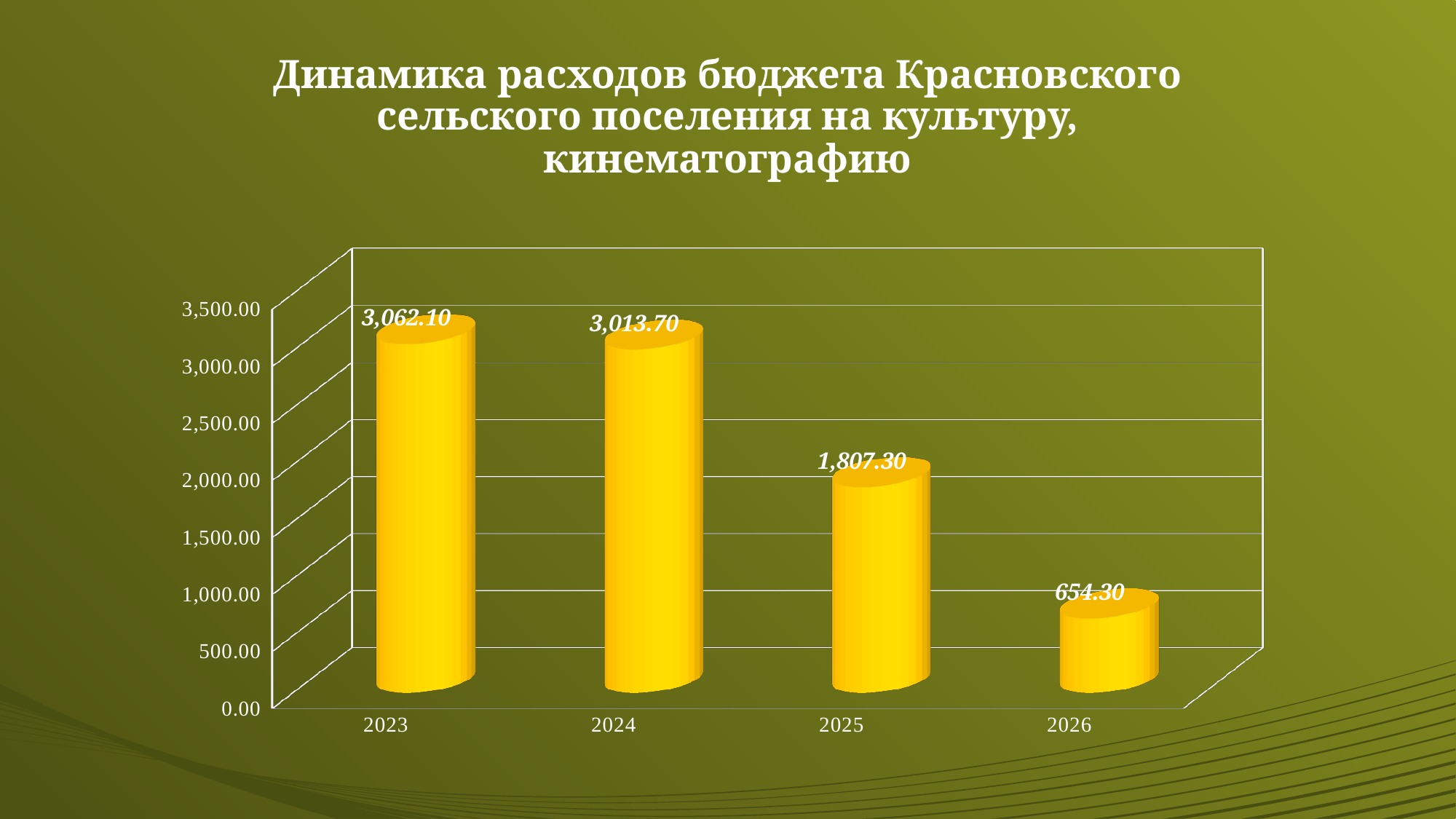
Which year has the lowest value? 2026 What is the value for 2023? 3,062.10 Which year has the highest value? 2023 What is the value for 2025? 1,807.30 What is the difference between the values for 2023 and 2024? 48.40 Do the values rise or fall from 2023 to 2026? fall What kind of chart is this? bar chart What is the value for 2024? 3,013.70 Which is larger, the value for 2024 or the value for 2025? 2024 What is the value for 2026? 654.30 What is the difference between the values for 2025 and 2026? 1,153.00 How many years are shown on the x axis? 4